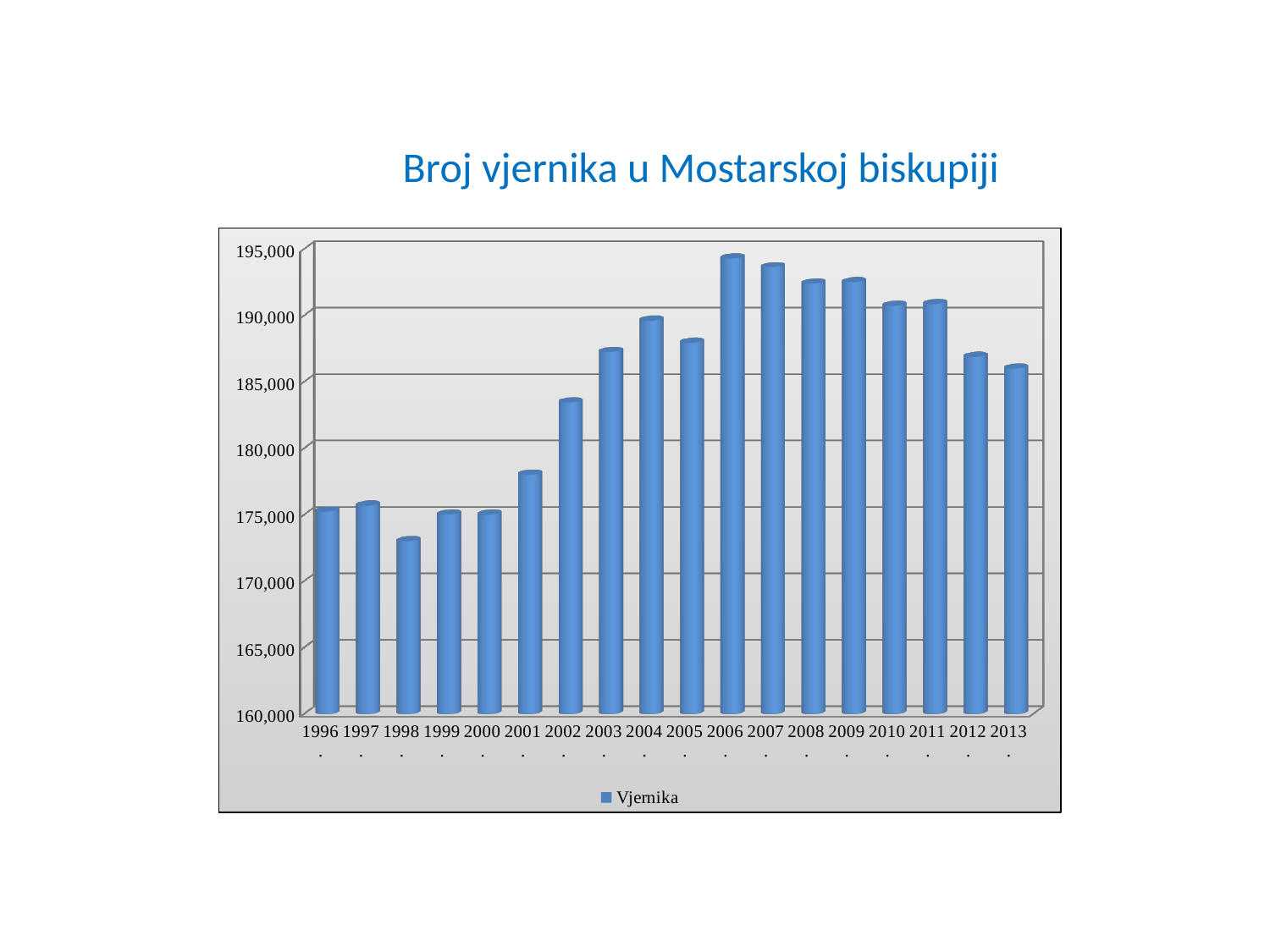
Which year has the highest value? 2006 What kind of chart is shown on the slide? bar chart How many years are plotted on the x axis? 18 How many series does the legend list? 1 What is the name of the series shown in the legend? Vjernika Do the values rise or fall from 2006 to 2013? fall Which is larger, the value for 2003 or the value for 2001? 2003 What is the title of the chart? Broj vjernika u Mostarskoj biskupiji Is the value for 2002 greater or less than 180,000? greater Is the value for 2006 greater or less than 190,000? greater Is the value for 1998 greater or less than 175,000? less Which year has the lowest value? 1998